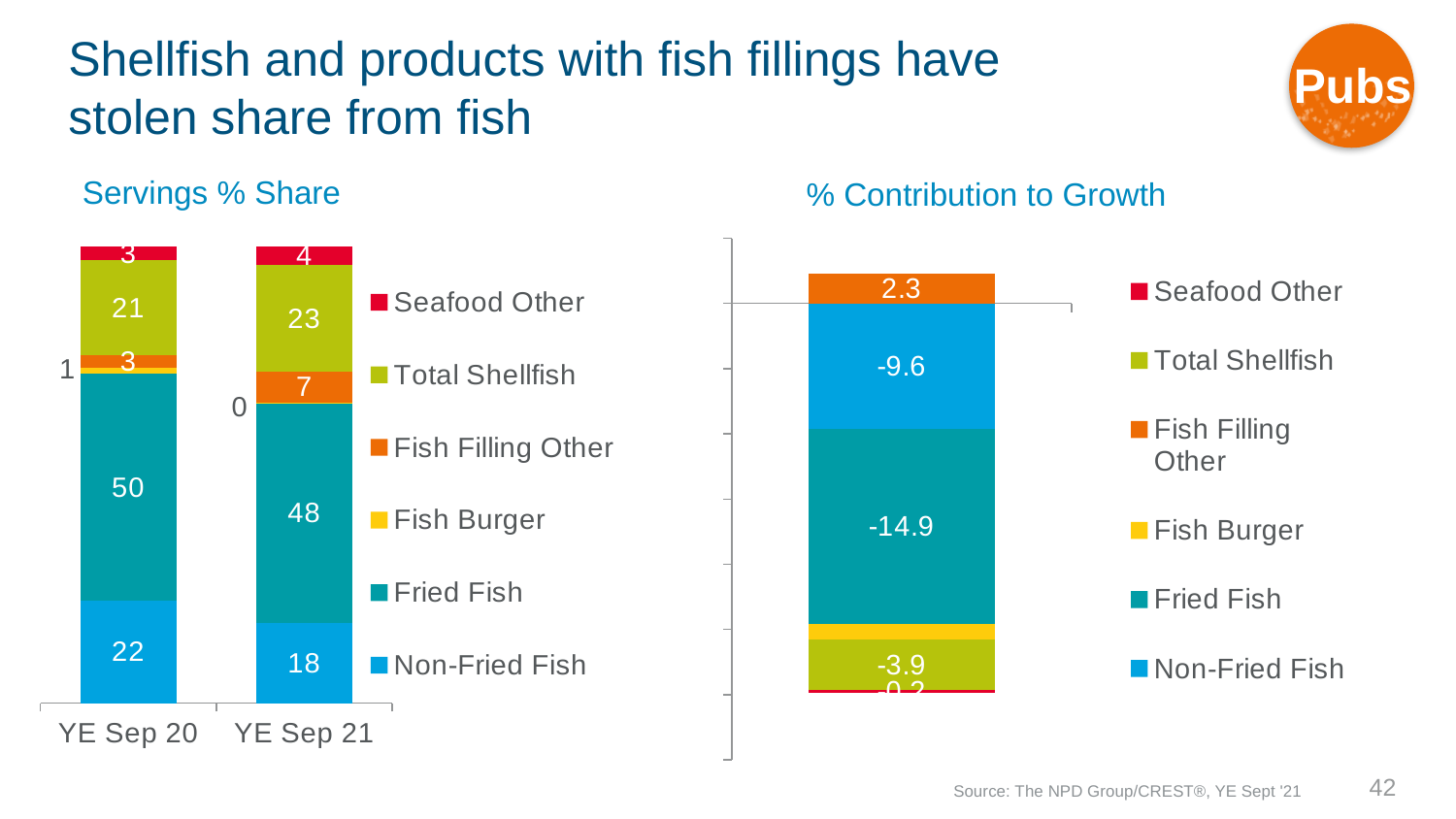
In the Servings % Share chart, what is the value for Fried Fish in YE Sep 20? 50 How many bars (categories) are shown in the Servings % Share chart? 2 In the Servings % Share chart, what is the value for Fish Filling Other in YE Sep 21? 7 In the Servings % Share chart, what is the value for Non-Fried Fish in YE Sep 21? 18 What kind of chart is the Servings % Share chart? Stacked bar chart In the Servings % Share chart, what is the difference between the Fried Fish values for YE Sep 20 and YE Sep 21? 2 In the % Contribution to Growth chart, which series has the lowest (most negative) value? Fried Fish In the % Contribution to Growth chart, what is the value for Fried Fish? -14.9 How many series does the legend of the Servings % Share chart list? 6 In the Servings % Share chart, what is the value for Total Shellfish in YE Sep 21? 23 In the % Contribution to Growth chart, what is the value for Non-Fried Fish? -9.6 In the Servings % Share chart, which year has the larger Total Shellfish value, YE Sep 20 or YE Sep 21? YE Sep 21